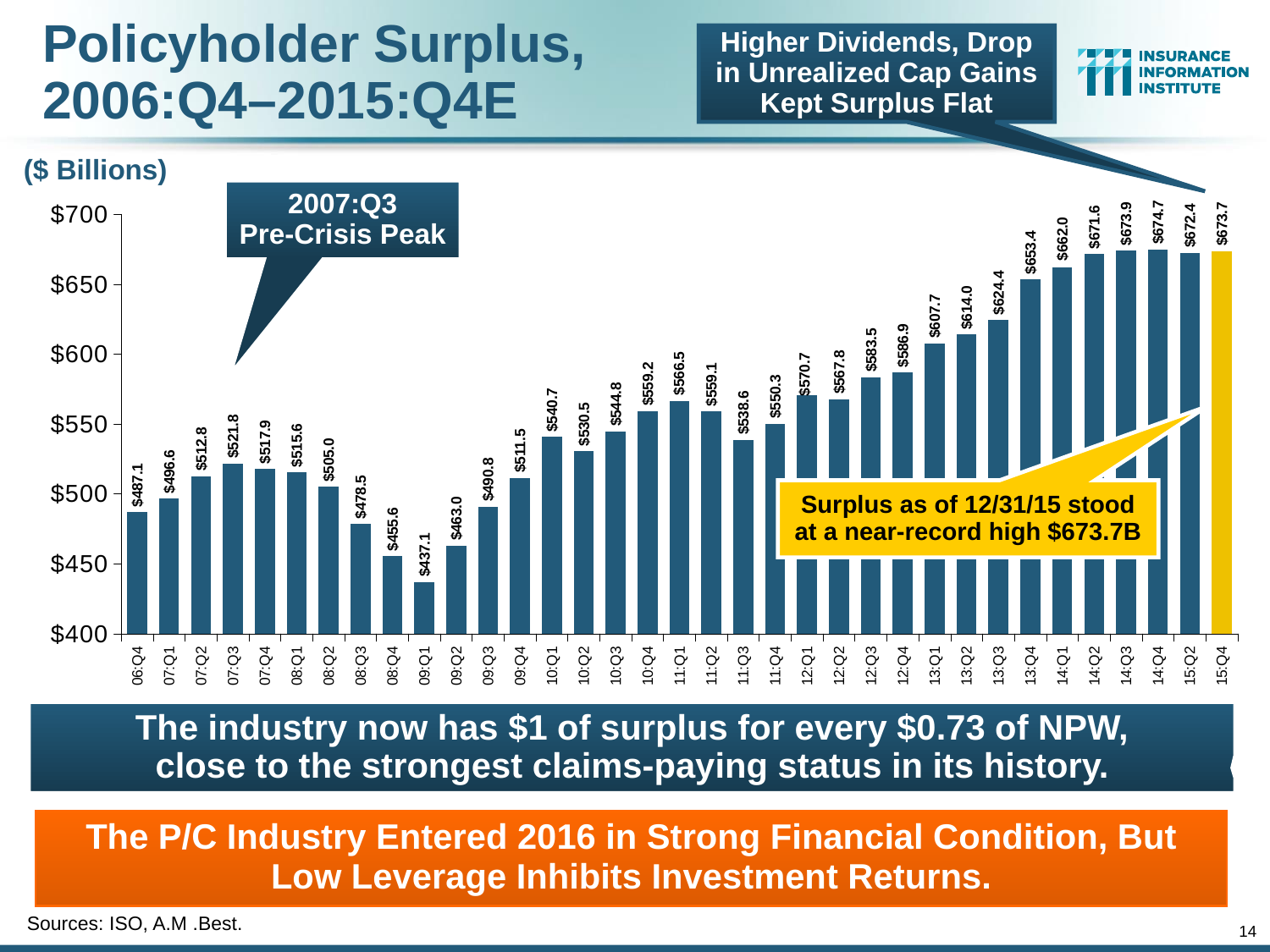
Which quarter has the highest policyholder surplus on the chart? 14:Q4 What is the difference between the surplus in 14:Q4 and in 15:Q4? $1.0 Which is larger, the surplus in 07:Q3 or in 07:Q4? 07:Q3 What is the difference between the surplus in 15:Q4 and in 06:Q4? $186.6 Do the surplus values rise or fall from 07:Q3 to 09:Q1? Fall What value is shown for 2007:Q3, labeled as the pre-crisis peak? $521.8 What is the policyholder surplus value for 15:Q4? $673.7 What is the policyholder surplus value for 09:Q1? $437.1 Which quarter has the lowest policyholder surplus on the chart? 09:Q1 What kind of chart is shown on the slide? Bar chart How many quarterly bars are plotted on the chart? 35 Which bar is highlighted in yellow rather than blue? 15:Q4